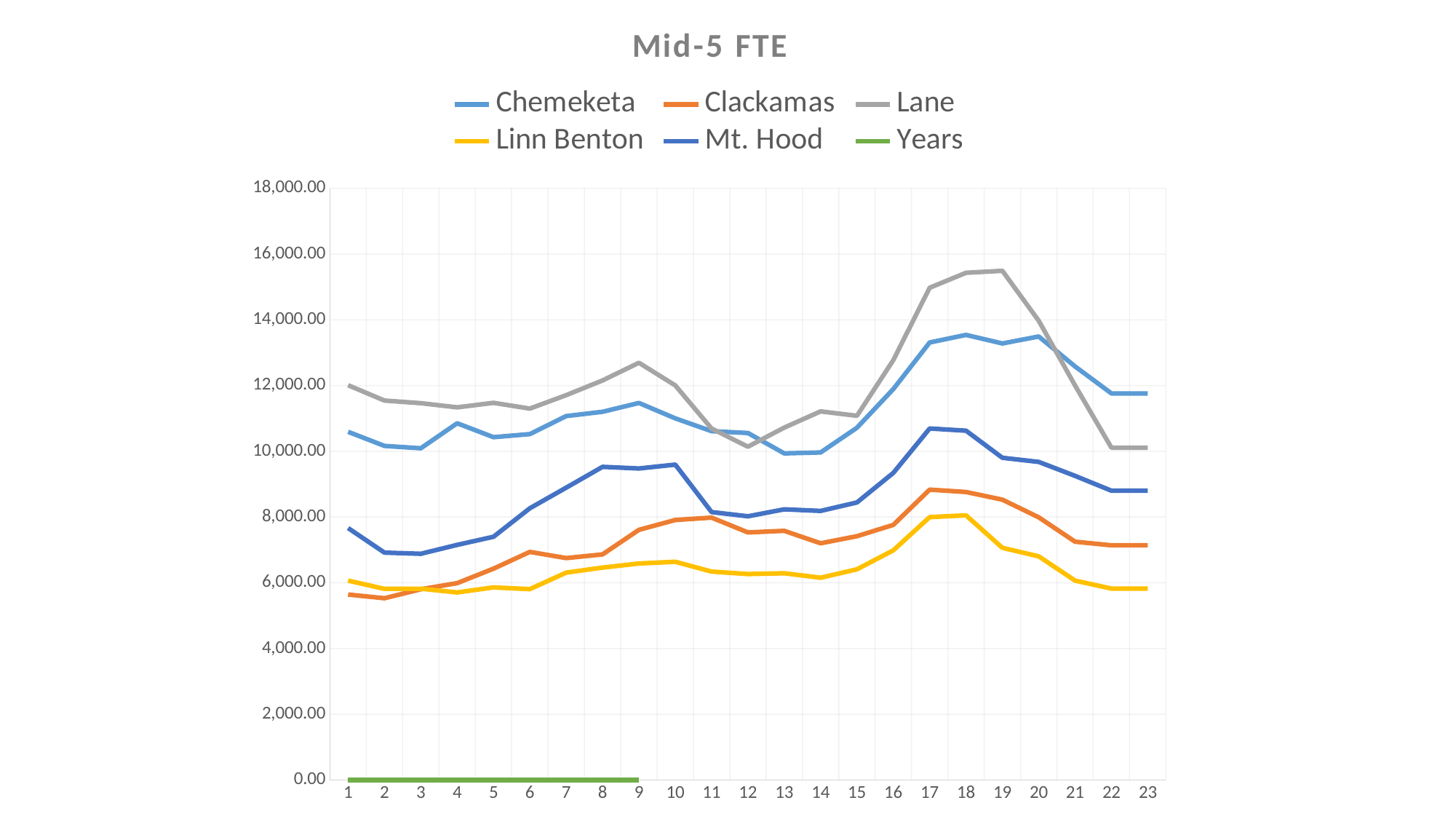
Is the value for Linn Benton at point 1 greater or less than 8,000.00? less What kind of chart is shown on the slide? line chart At point 10, which is larger: Mt. Hood or Clackamas? Mt. Hood Is the value for Clackamas at point 2 greater or less than 6,000.00? less What is the title of the chart? Mid-5 FTE Which series has the lowest value at point 23? Linn Benton At point 18, which is larger: Lane or Chemeketa? Lane Which series has the highest value at point 17? Lane How many points are on the x axis? 23 Is the value for Lane at point 19 greater or less than 14,000.00? greater How many series does the legend list? 6